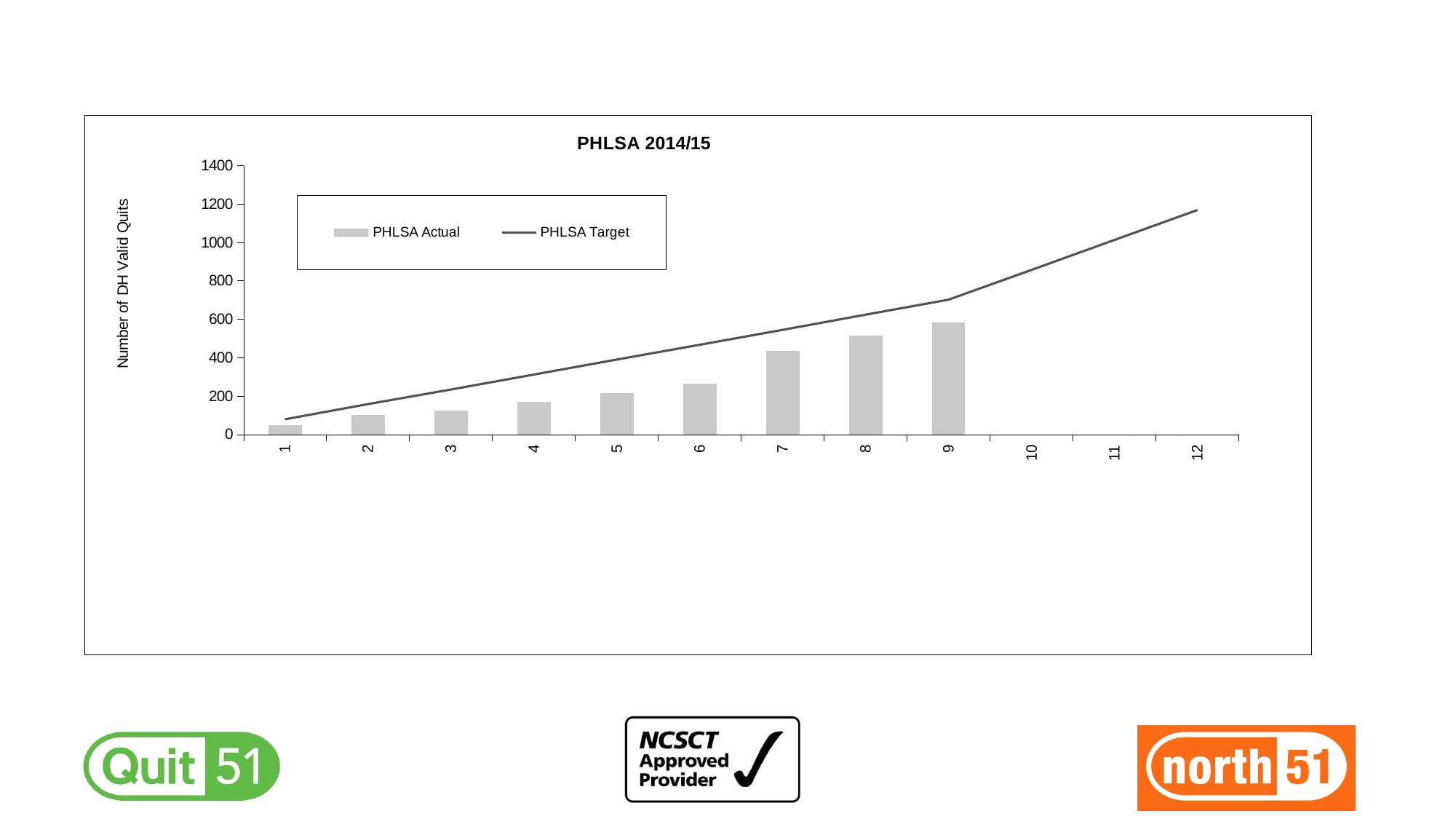
How many categories have a PHLSA Actual bar plotted? 9 Which category has the lowest PHLSA Actual bar? 1 Is the PHLSA Actual value for category 7 greater or less than 400? greater Is the PHLSA Actual value for category 9 greater or less than 600? less At category 9, which is larger: PHLSA Actual or PHLSA Target? PHLSA Target How many series does the legend list? 2 What is the title of the chart? PHLSA 2014/15 Do the PHLSA Actual bars rise or fall from category 1 to category 9? Rise What is the label on the vertical axis? Number of DH Valid Quits Is the PHLSA Target value at category 12 greater or less than 1000? greater Which category has the highest PHLSA Actual bar? 9 What kind of chart is shown on the slide? Bar chart with a line